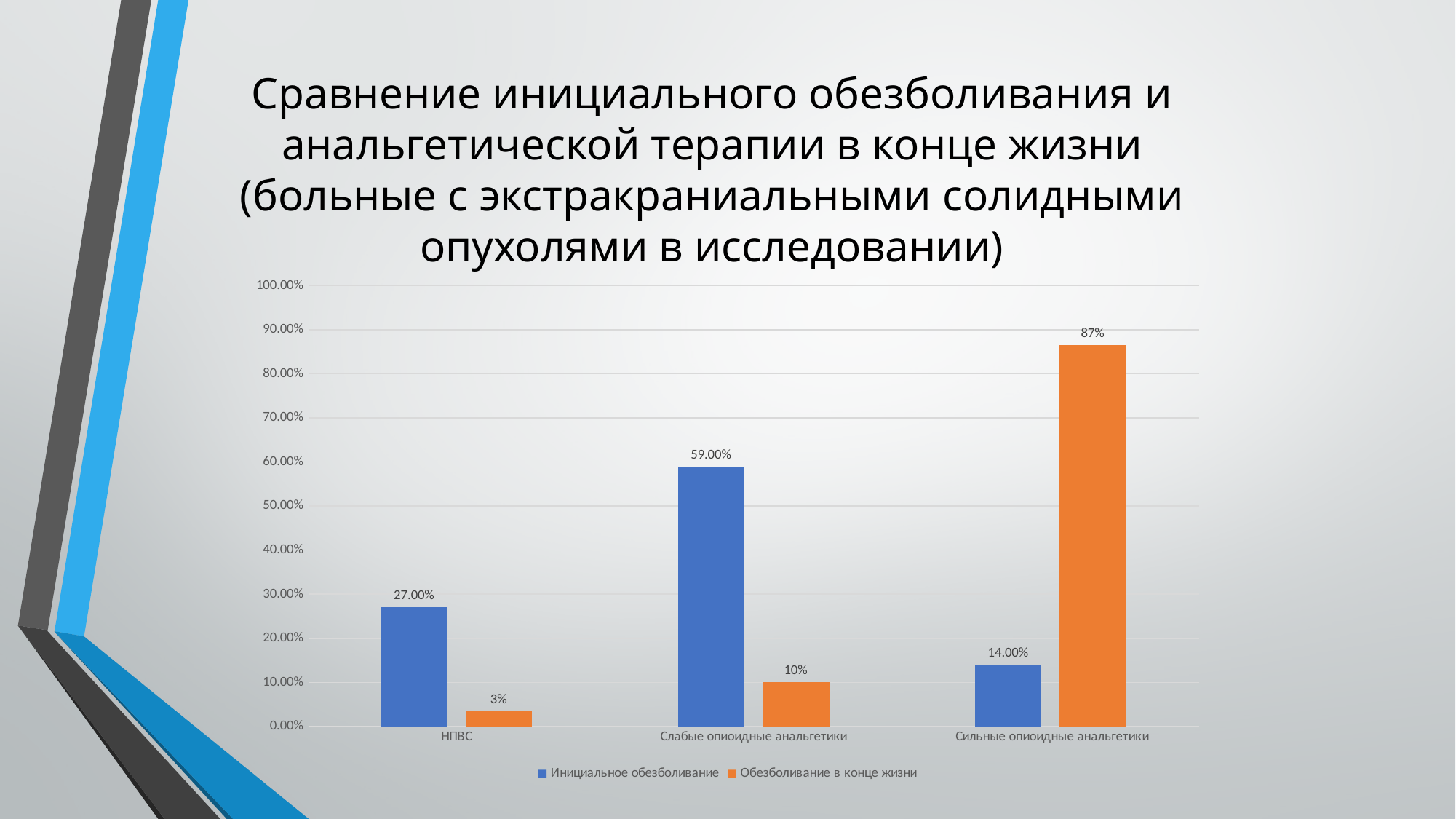
How many series does the legend list? 2 What is the value for Сильные опиоидные анальгетики in the Обезболивание в конце жизни series? 87% What is the value for Слабые опиоидные анальгетики in the Инициальное обезболивание series? 59.00% What colour are the bars for the Обезболивание в конце жизни series? Orange Which category has the highest value in the Инициальное обезболивание series? Слабые опиоидные анальгетики What kind of chart is shown on the slide? Bar chart Which category has the lowest value in the Обезболивание в конце жизни series? НПВС What is the difference between the Обезболивание в конце жизни and Инициальное обезболивание values for Сильные опиоидные анальгетики? 73 percentage points What is the value for НПВС in the Обезболивание в конце жизни series? 3% For Слабые опиоидные анальгетики, which series has the larger value: Инициальное обезболивание or Обезболивание в конце жизни? Инициальное обезболивание How many categories are shown on the x axis? 3 What is the value for НПВС in the Инициальное обезболивание series? 27.00%